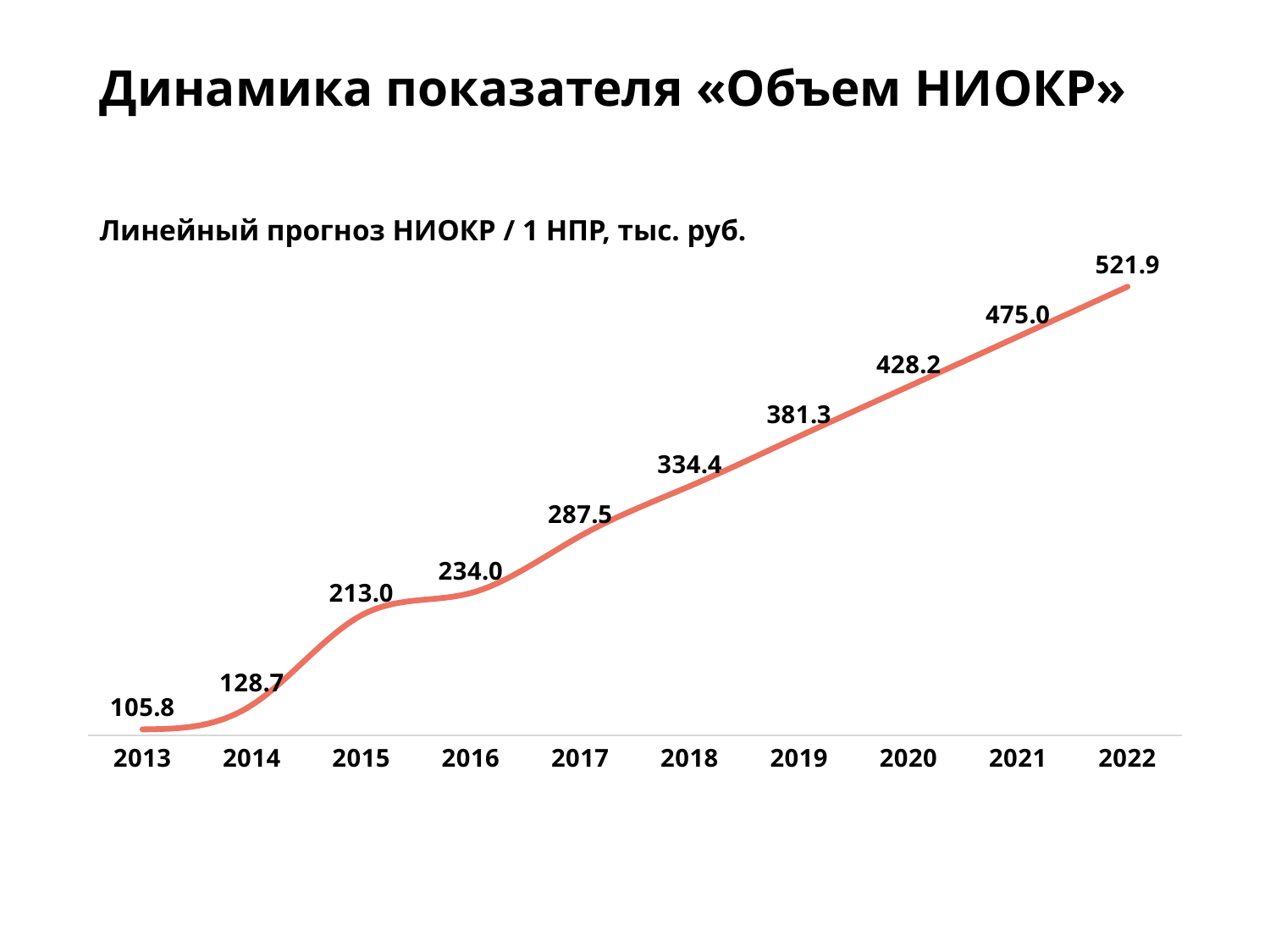
Which year has the highest value? 2022 What is the title of the chart? Линейный прогноз НИОКР / 1 НПР, тыс. руб. How many years are plotted on the chart? 10 What is the value for 2013? 105.8 What is the value for 2020? 428.2 What is the difference between the values for 2022 and 2013? 416.1 Which year has the lowest value? 2013 Do the values rise or fall from 2013 to 2022? rise What is the value for 2017? 287.5 What is the difference between the values for 2015 and 2014? 84.3 Which is larger, the value for 2016 or the value for 2019? 2019 What kind of chart is shown on the slide? line chart